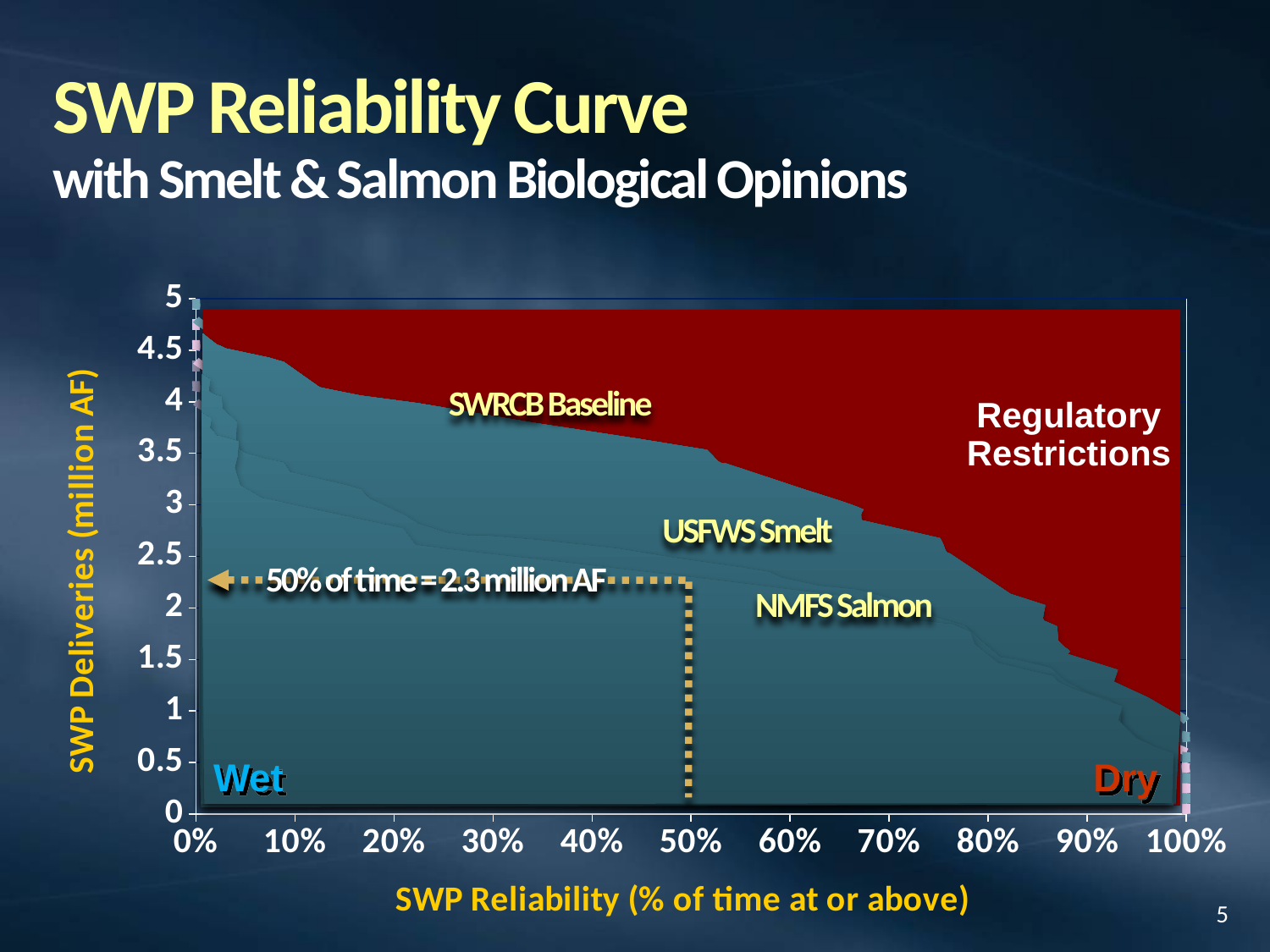
What kind of chart is shown on the slide? Area chart What is the label of the y-axis? SWP Deliveries (million AF) What is the label of the x-axis? SWP Reliability (% of time at or above) Which end of the x-axis is labelled 'Dry', the 0% end or the 100% end? 100% end What is the highest value shown on the y-axis? 5 Is the value of the lower (teal) curve at 90% reliability greater or less than 2 million AF? less Is the value of the lower (teal) curve at 80% reliability greater or less than 2 million AF? greater Do SWP deliveries rise or fall as reliability increases from 0% to 100%? Fall Is the value of the lower (teal) curve at 10% reliability greater or less than 4 million AF? greater How many tick labels are shown on the x-axis? 11 According to the annotation on the chart, what is the SWP delivery amount at 50% reliability? 2.3 million AF